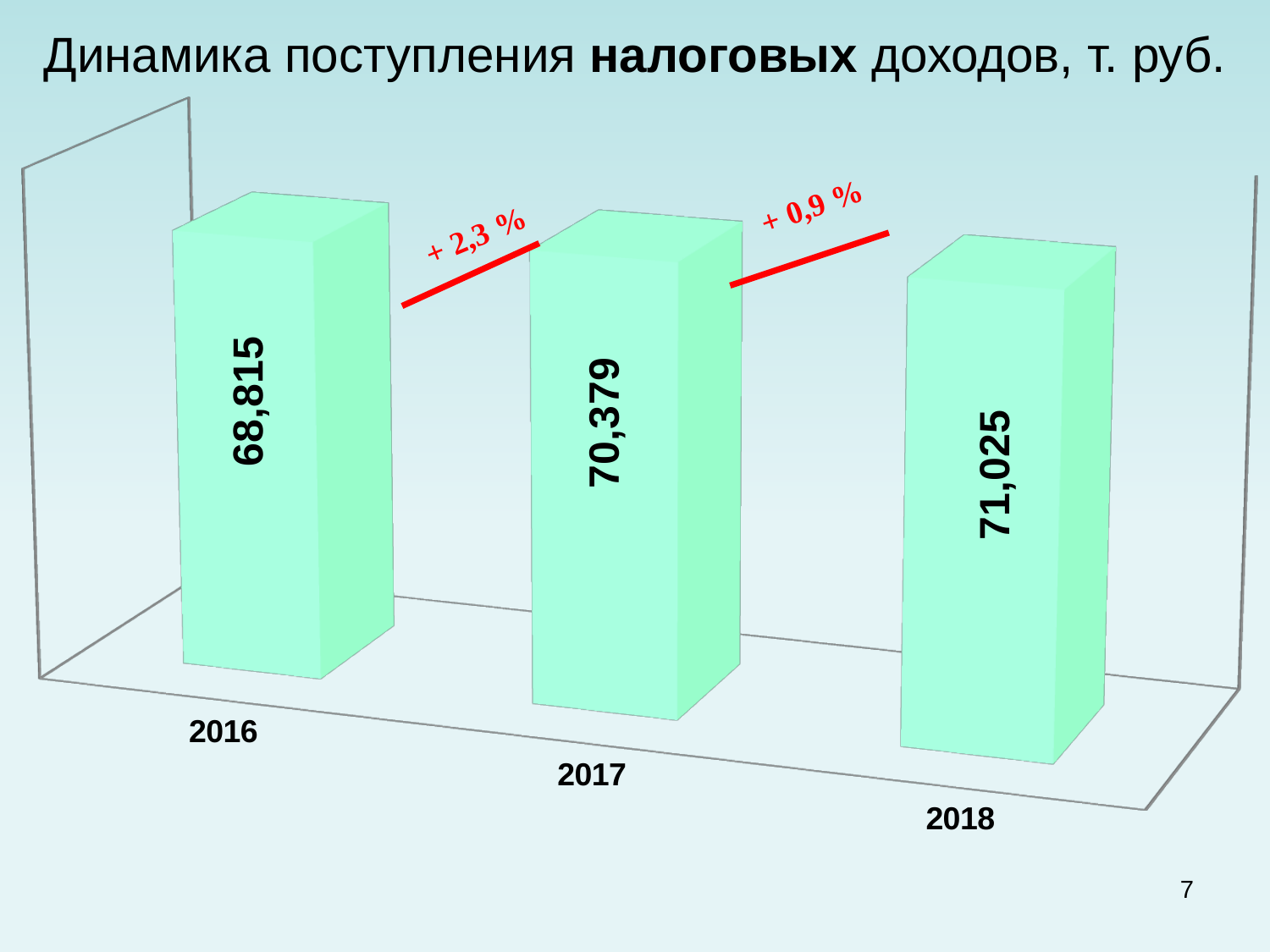
What percentage change is annotated between 2016 and 2017? + 2,3 % What is the difference between the values for 2017 and 2016? 1,564 What is the difference between the values for 2018 and 2017? 646 Which year has the lowest value? 2016 Which year has the highest value? 2018 What is the value for 2017? 70,379 Do the values rise or fall from 2016 to 2018? Rise What is the value for 2018? 71,025 How many years are shown on the chart? 3 Which is larger, the value for 2016 or the value for 2018? 2018 What is the value for 2016? 68,815 What kind of chart is shown on the slide? Bar chart